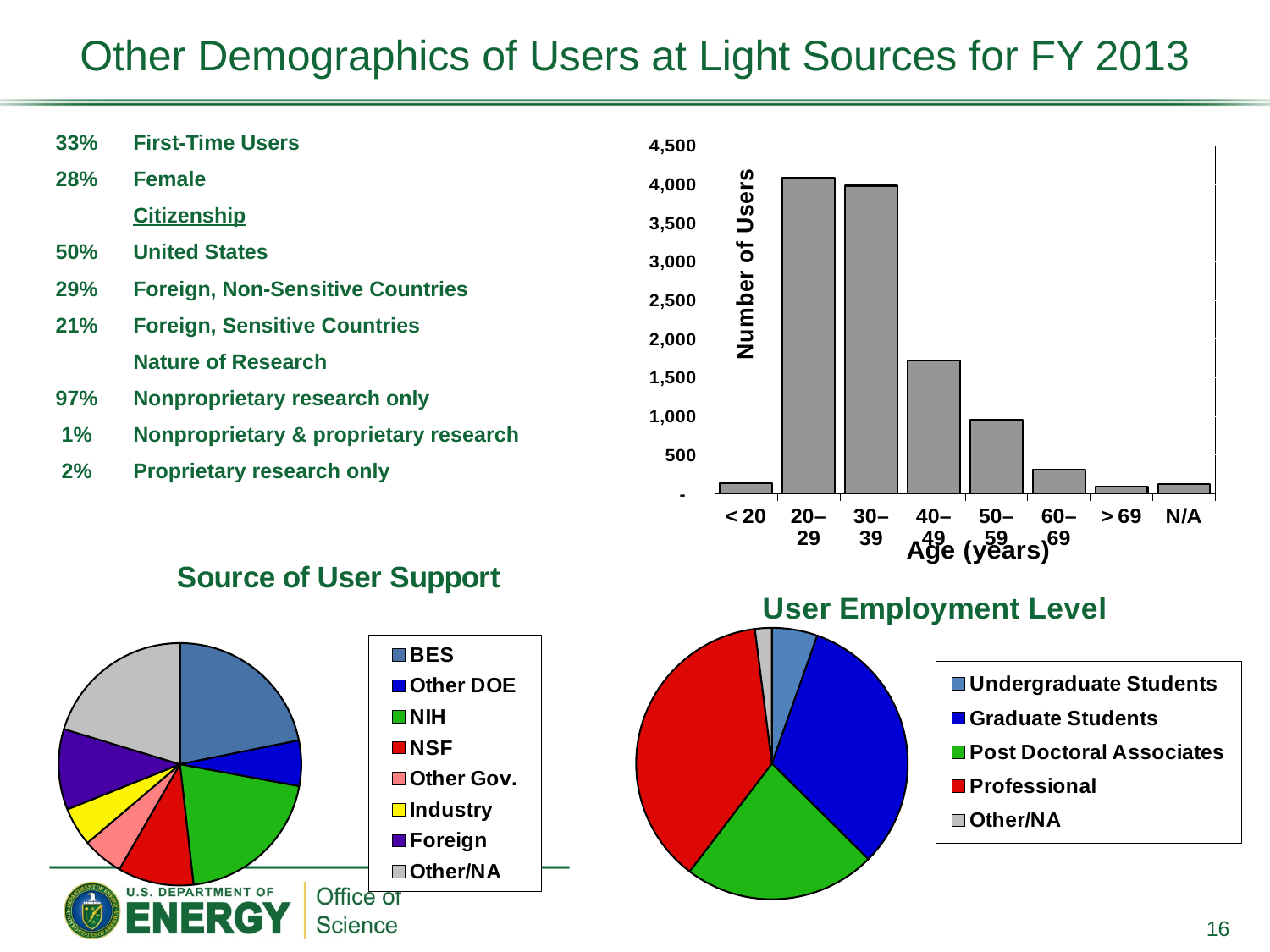
In the Number of Users bar chart, is the value for the 30–39 age group greater or less than 3,500? greater How many entries does the legend of the Source of User Support chart list? 8 What type of chart is the Source of User Support chart? pie chart How many categories does the legend of the User Employment Level chart list? 5 In the User Employment Level pie chart, which category has the largest slice? Professional In the Number of Users bar chart, is the value for the 60–69 age group greater or less than 500? less In the Number of Users bar chart, do the values rise or fall from the 20–29 age group through the > 69 age group? fall What type of chart is the chart showing Number of Users by Age (years)? bar chart In the Number of Users bar chart, is the value for the 40–49 age group greater or less than 1,500? greater How many age categories are shown on the x axis of the Number of Users bar chart? 8 In the Number of Users bar chart, which age group has more users: 20–29 or 40–49? 20–29 In the User Employment Level pie chart, which slice is larger: Graduate Students or Undergraduate Students? Graduate Students